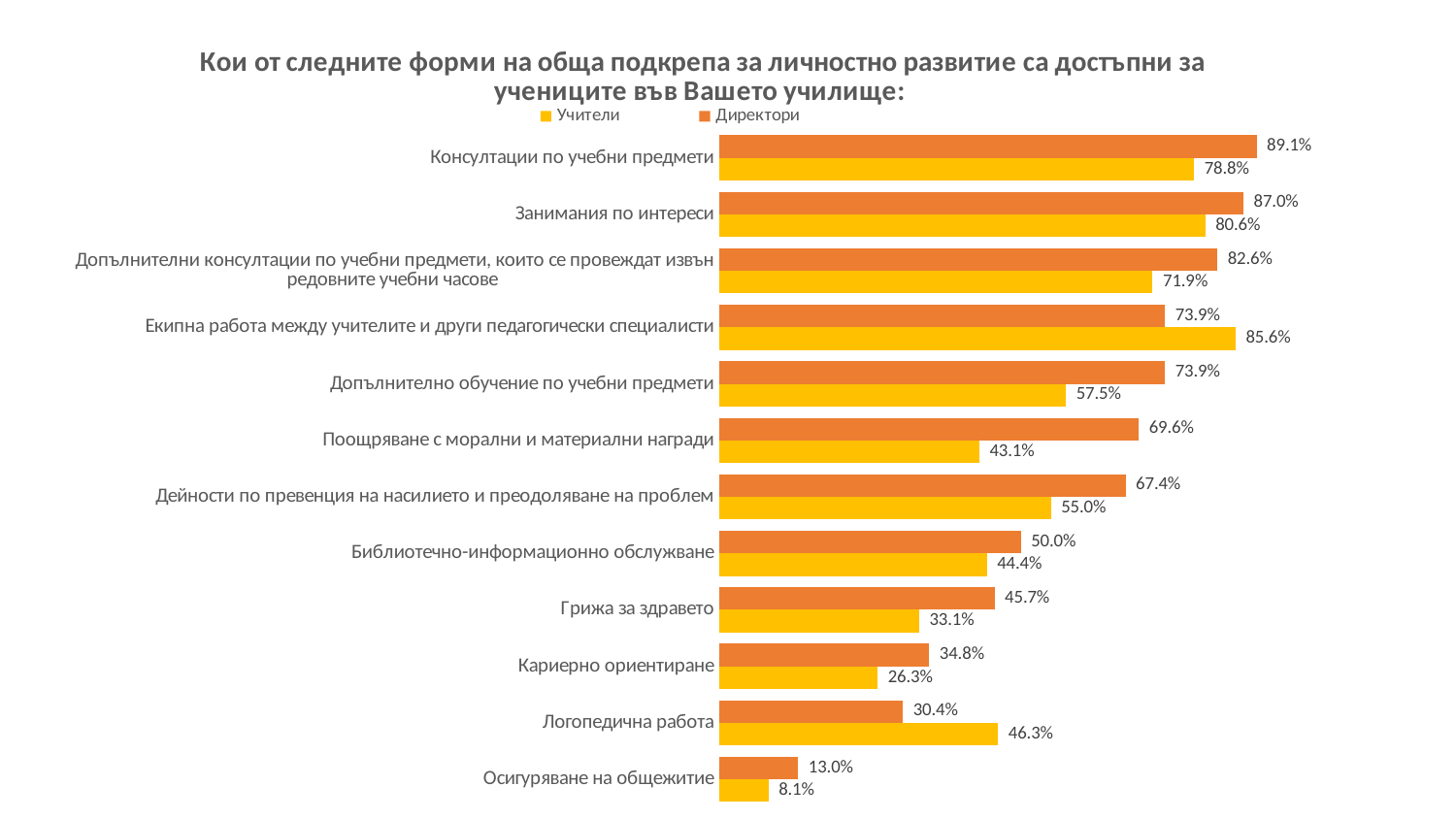
How many categories are shown in the chart? 12 Which colour represents the Директори series? orange What is the difference between the Директори and Учители values for 'Осигуряване на общежитие'? 4.9% What is the value for Учители for 'Екипна работа между учителите и други педагогически специалисти'? 85.6% What is the value for Директори for 'Консултации по учебни предмети'? 89.1% What type of chart is shown on the slide? bar chart How many series does the legend list? 2 For 'Логопедична работа', which series has the larger value, Учители or Директори? Учители Which category has the lowest value for Директори? Осигуряване на общежитие What is the value for Учители for 'Логопедична работа'? 46.3% What is the difference between the Директори and Учители values for 'Поощряване с морални и материални награди'? 26.5% Which category has the highest value for Учители? Екипна работа между учителите и други педагогически специалисти